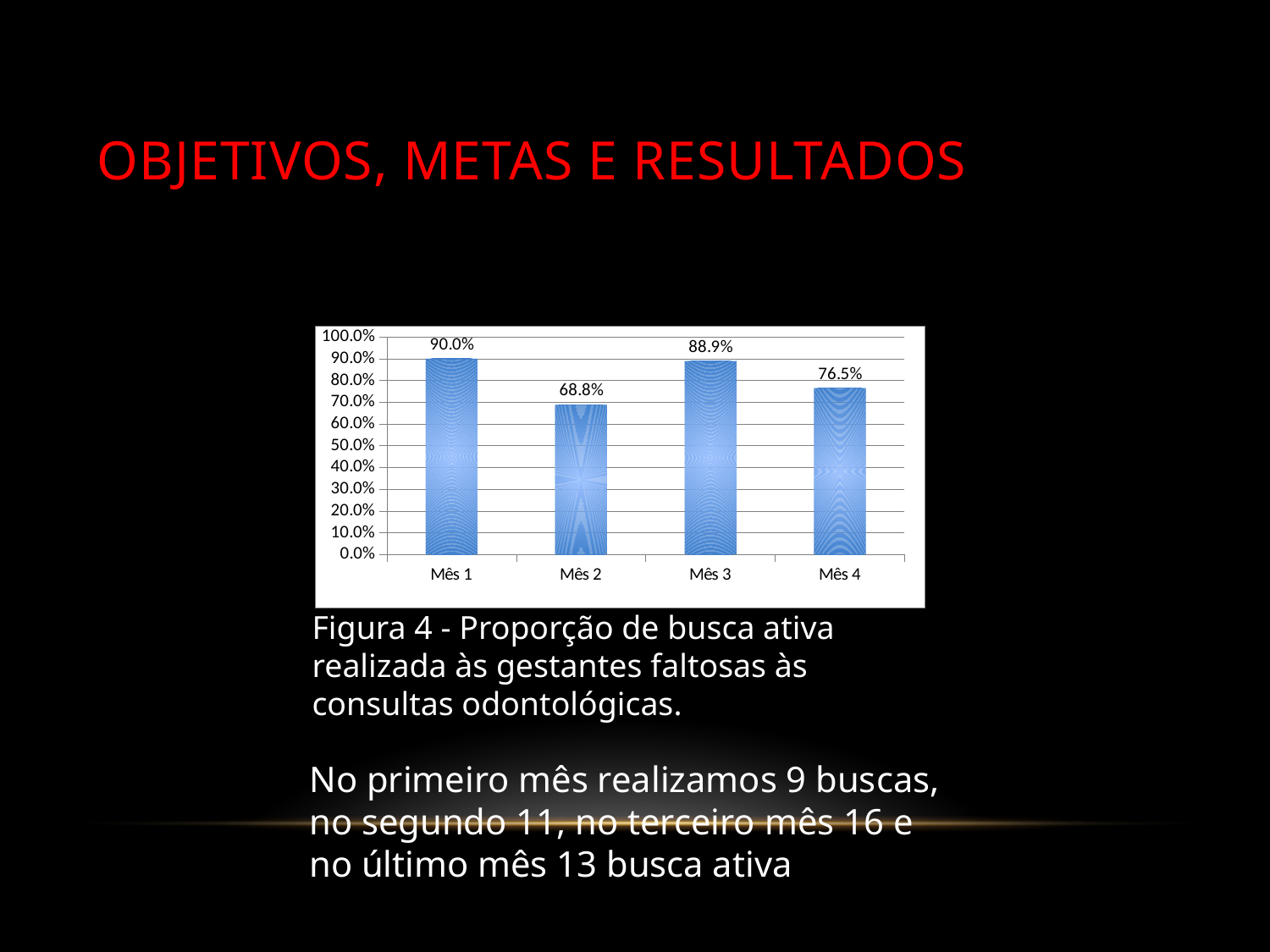
What is the value for Mês 4? 76.5% What is the difference between the values for Mês 1 and Mês 2? 21.2% What is the value for Mês 3? 88.9% Which month has the highest value? Mês 1 How many months are shown on the chart? 4 Is the value for Mês 2 greater or less than 70.0%? less Which month has the lowest value? Mês 2 What is the difference between the values for Mês 3 and Mês 4? 12.4% What is the value for Mês 2? 68.8% Which is larger, the value for Mês 2 or the value for Mês 4? Mês 4 What is the value for Mês 1? 90.0% What kind of chart is shown on the slide? bar chart